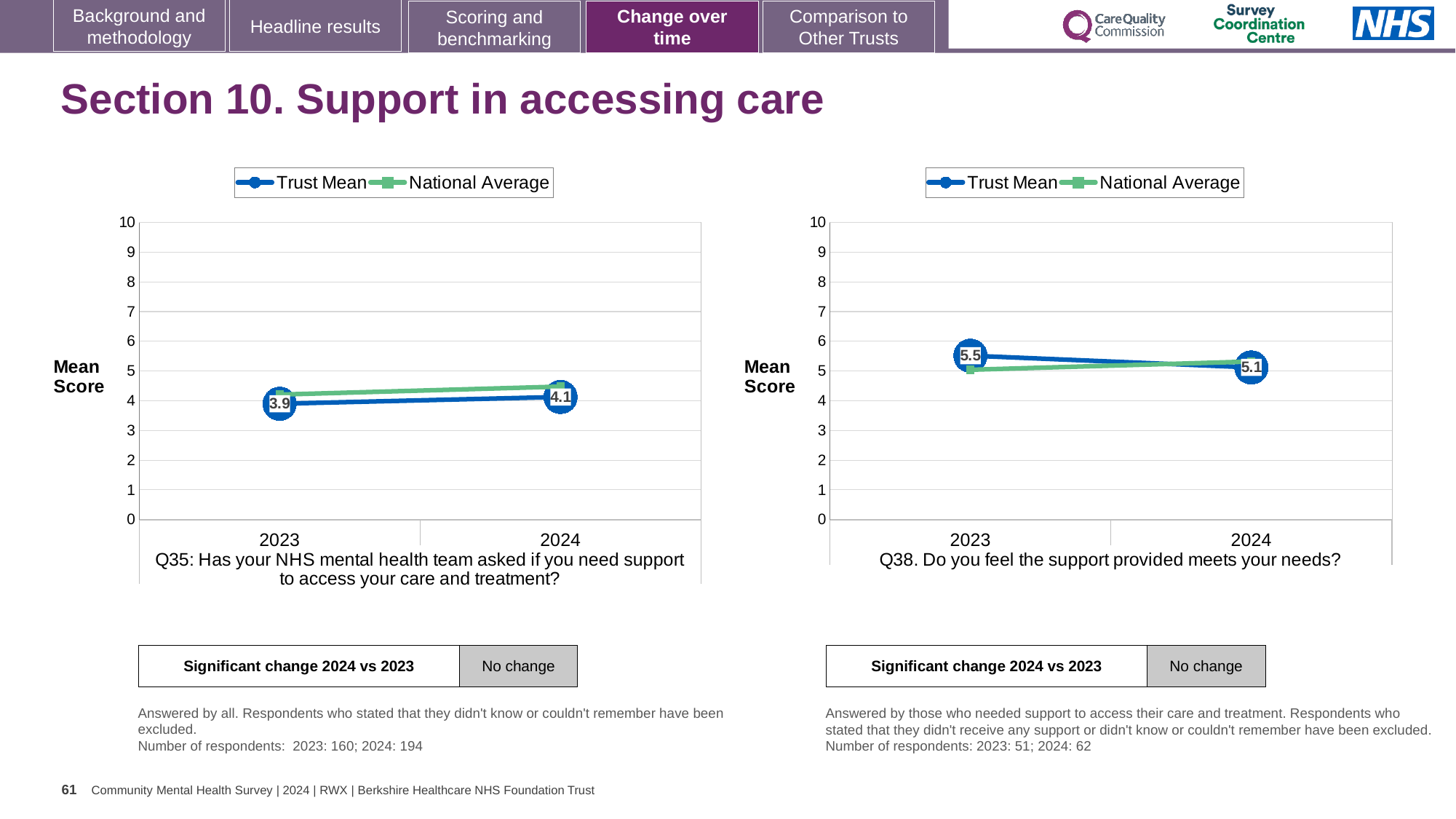
In the Q38 chart on the right, does the Trust Mean rise or fall from 2023 to 2024? fall In the Q35 chart on the left, does the Trust Mean rise or fall from 2023 to 2024? rise In the Q38 chart on the right, what is the Trust Mean score for 2024? 5.1 In the Q35 chart on the left, what is the Trust Mean score for 2023? 3.9 What kind of chart is the Q38 chart on the right? line chart In the Q35 chart on the left, what is the Trust Mean score for 2024? 4.1 How many series does the legend of the Q35 chart on the left list? 2 In the Q38 chart on the right, what is the Trust Mean score for 2023? 5.5 In the Q35 chart on the left, is the National Average for 2024 greater or less than 4? greater In the Q35 chart on the left, by how much did the Trust Mean change from 2023 to 2024? 0.2 In the Q38 chart on the right, is the Trust Mean for 2023 greater or less than 5? greater In the Q38 chart on the right, what is the difference between the Trust Mean in 2023 and 2024? 0.4